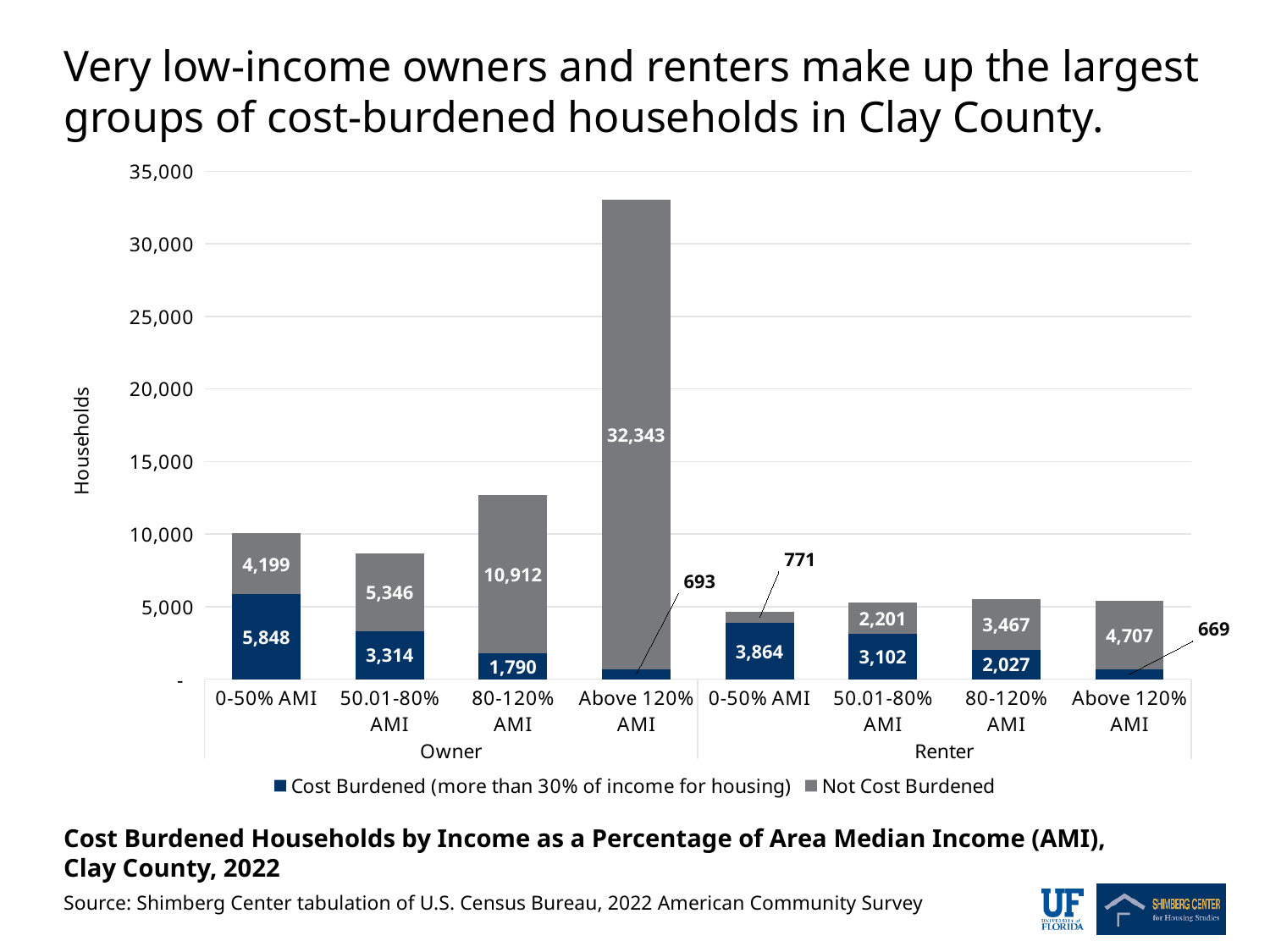
What is the difference between cost-burdened owner households and cost-burdened renter households in the 0-50% AMI group? 1,984 What type of chart is shown on the slide? Stacked bar chart Which renter income group has the smallest number of cost-burdened households? Above 120% AMI How many income-group bars are shown in the chart in total across owners and renters? 8 Which income group has the largest number of cost-burdened owner households? 0-50% AMI What is the number of not cost-burdened renter households in the 0-50% AMI group? 771 What is the number of not cost-burdened owner households in the Above 120% AMI group? 32,343 How many series does the legend list? 2 What is the number of cost-burdened owner households in the 0-50% AMI group? 5,848 What is the total number of renter households in the 0-50% AMI group (cost burdened plus not cost burdened)? 4,635 Which is larger: the number of cost-burdened renter households in the 50.01-80% AMI group or the number of not cost-burdened renter households in that group? Cost Burdened (3,102) What is the number of cost-burdened renter households in the 80-120% AMI group? 2,027